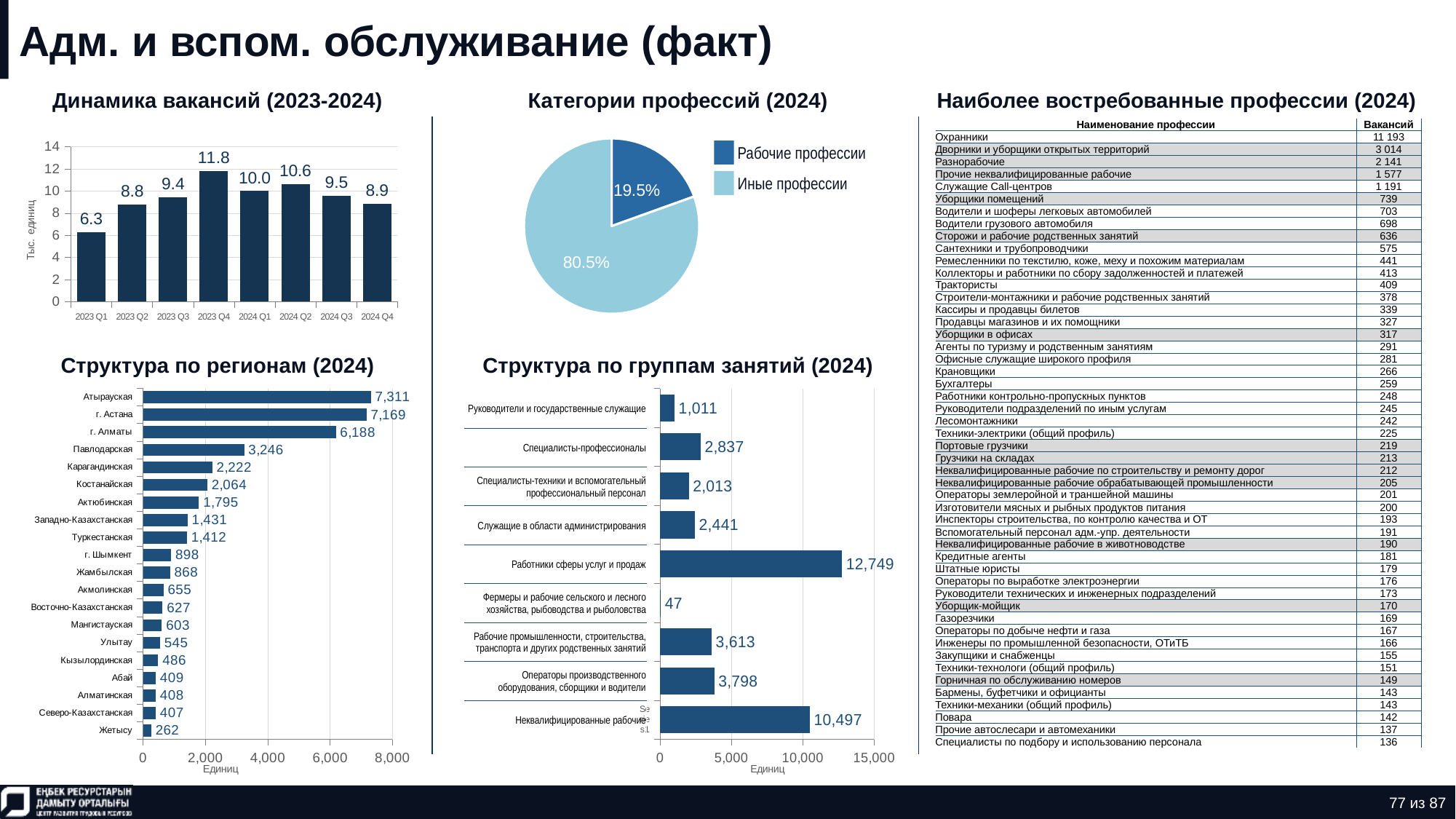
In the chart 'Структура по регионам (2024)', which is larger: г. Астана or г. Алматы? г. Астана What kind of chart is 'Категории профессий (2024)'? pie chart In the chart 'Динамика вакансий (2023-2024)', how many quarters are plotted? 8 In the chart 'Динамика вакансий (2023-2024)', what is the difference between 2024 Q2 and 2024 Q4? 1.7 In the chart 'Динамика вакансий (2023-2024)', what is the value for 2023 Q4? 11.8 In the chart 'Структура по регионам (2024)', which region has the highest value? Атырауская In the chart 'Структура по группам занятий (2024)', which group has the lowest value? Фермеры и рабочие сельского и лесного хозяйства, рыбоводства и рыболовства In the chart 'Категории профессий (2024)', what share does 'Иные профессии' have? 80.5% In the chart 'Структура по регионам (2024)', what is the value for Павлодарская? 3,246 In the chart 'Структура по группам занятий (2024)', what is the value for 'Работники сферы услуг и продаж'? 12,749 In the chart 'Категории профессий (2024)', how many entries does the legend list? 2 In the chart 'Динамика вакансий (2023-2024)', which quarter has the lowest value? 2023 Q1